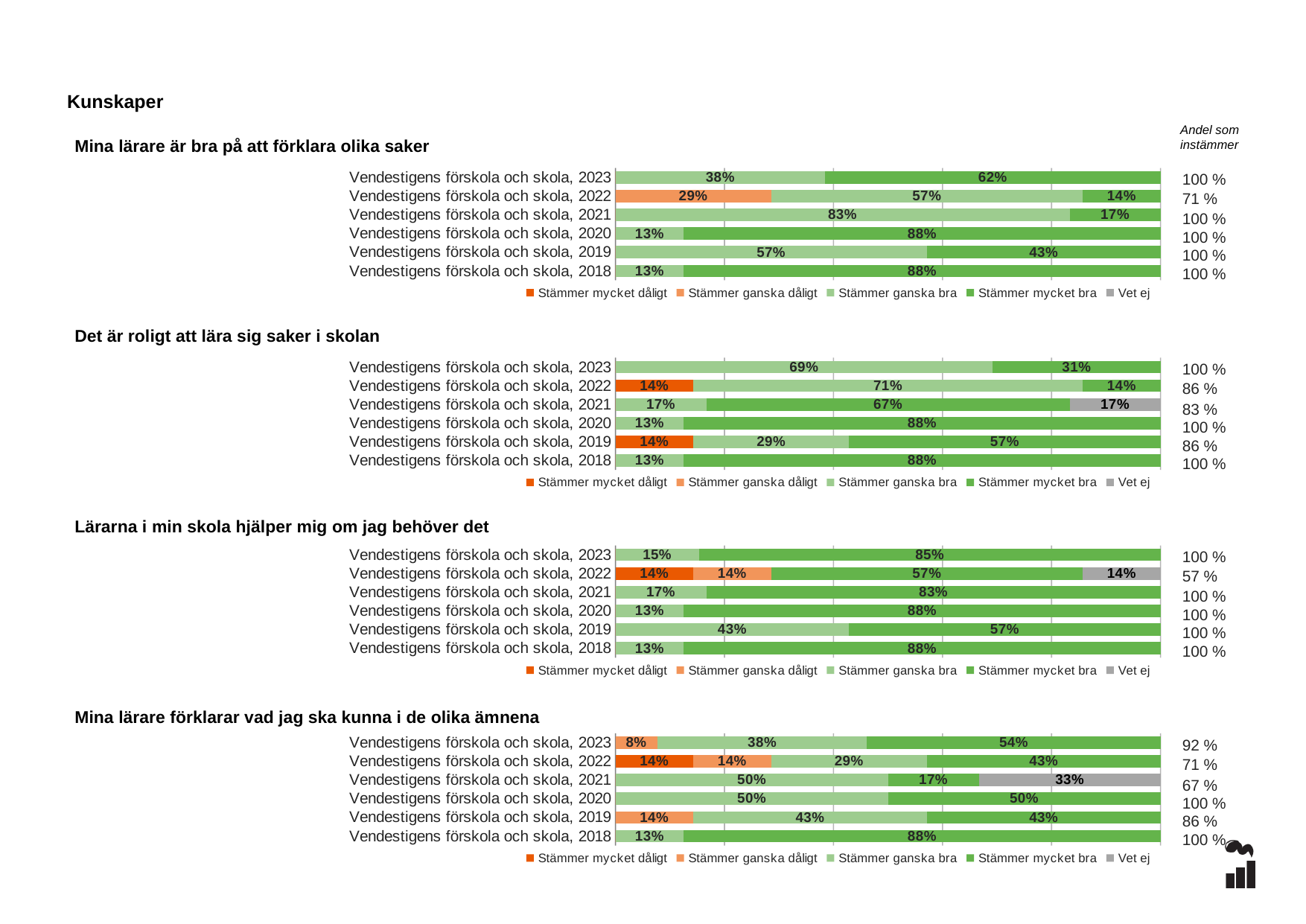
In the chart 'Mina lärare förklarar vad jag ska kunna i de olika ämnena', what is the 'Vet ej' value for Vendestigens förskola och skola, 2021? 33% In the chart 'Mina lärare är bra på att förklara olika saker', what is the 'Stämmer ganska dåligt' value for Vendestigens förskola och skola, 2022? 29% In the chart 'Mina lärare förklarar vad jag ska kunna i de olika ämnena', what is the 'Andel som instämmer' for Vendestigens förskola och skola, 2022? 71 % How many bars are shown in the chart 'Mina lärare är bra på att förklara olika saker'? 6 In the chart 'Mina lärare förklarar vad jag ska kunna i de olika ämnena', which is larger for 2023: 'Stämmer ganska bra' or 'Stämmer mycket bra'? Stämmer mycket bra What kind of chart is 'Lärarna i min skola hjälper mig om jag behöver det'? Stacked bar chart In the chart 'Lärarna i min skola hjälper mig om jag behöver det', what is the difference between the 'Stämmer mycket bra' values for 2019 and 2018? 31% In the chart 'Det är roligt att lära sig saker i skolan', what is the 'Vet ej' value for Vendestigens förskola och skola, 2021? 17% In the chart 'Mina lärare är bra på att förklara olika saker', what is the 'Stämmer mycket bra' value for Vendestigens förskola och skola, 2023? 62% How many series does the legend list for the chart 'Det är roligt att lära sig saker i skolan'? 5 In the chart 'Lärarna i min skola hjälper mig om jag behöver det', what is the 'Stämmer mycket bra' value for Vendestigens förskola och skola, 2023? 85% In the chart 'Det är roligt att lära sig saker i skolan', which year has the highest 'Stämmer ganska bra' value? Vendestigens förskola och skola, 2022